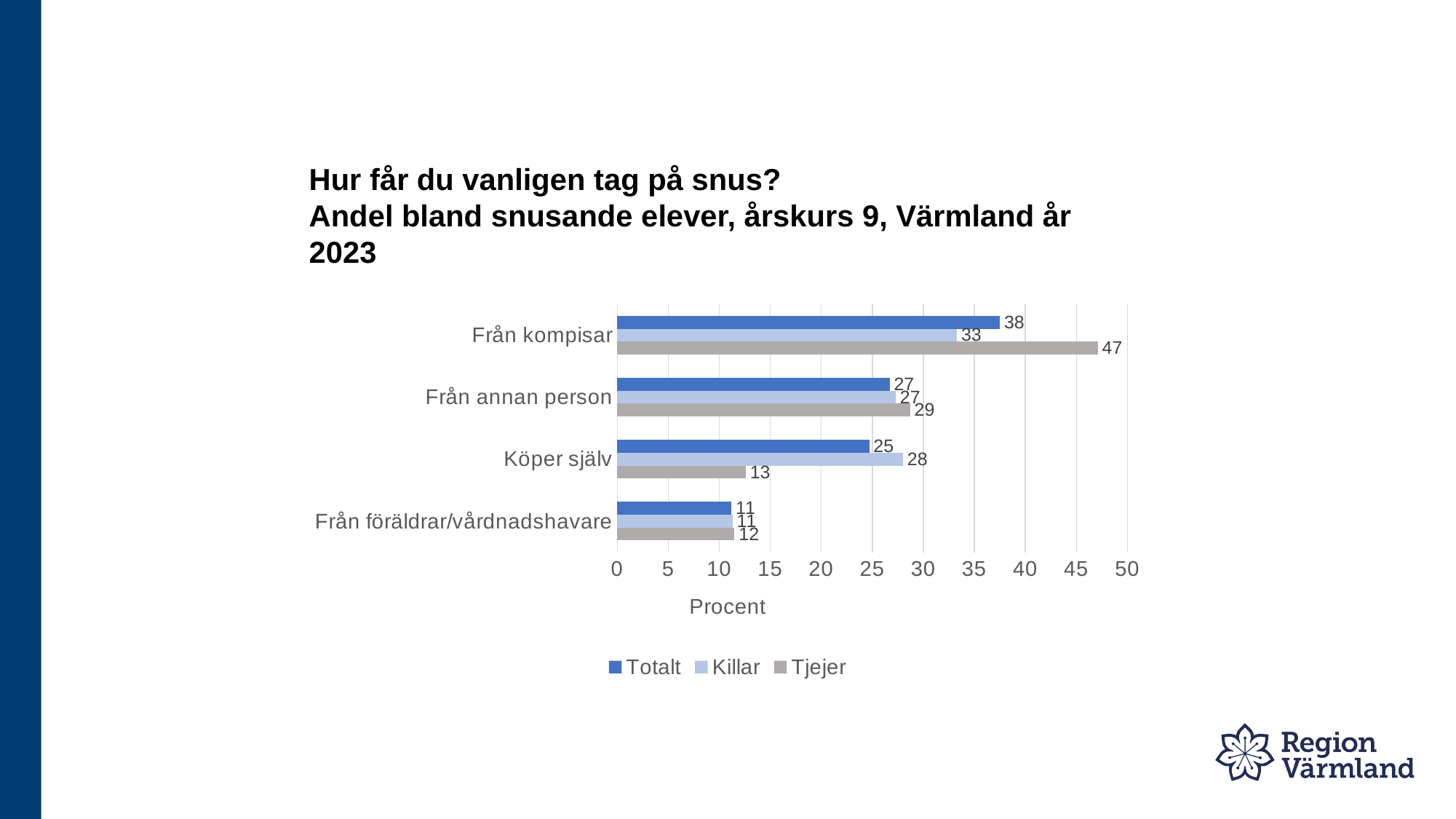
How many categories are shown on the y axis? 4 How many series does the legend list? 3 What is the difference between the Tjejer and Killar values for Från kompisar? 14 Is the Totalt value for Från kompisar greater or less than 35? greater Which is larger for Köper själv, the Killar value or the Tjejer value? Killar Which category has the highest Totalt value? Från kompisar What is the Totalt value for Från annan person? 27 Which category has the lowest Tjejer value? Från föräldrar/vårdnadshavare What kind of chart is shown on the slide? Bar chart What is the Tjejer value for Från kompisar? 47 What is the label of the x axis? Procent What is the Killar value for Köper själv? 28